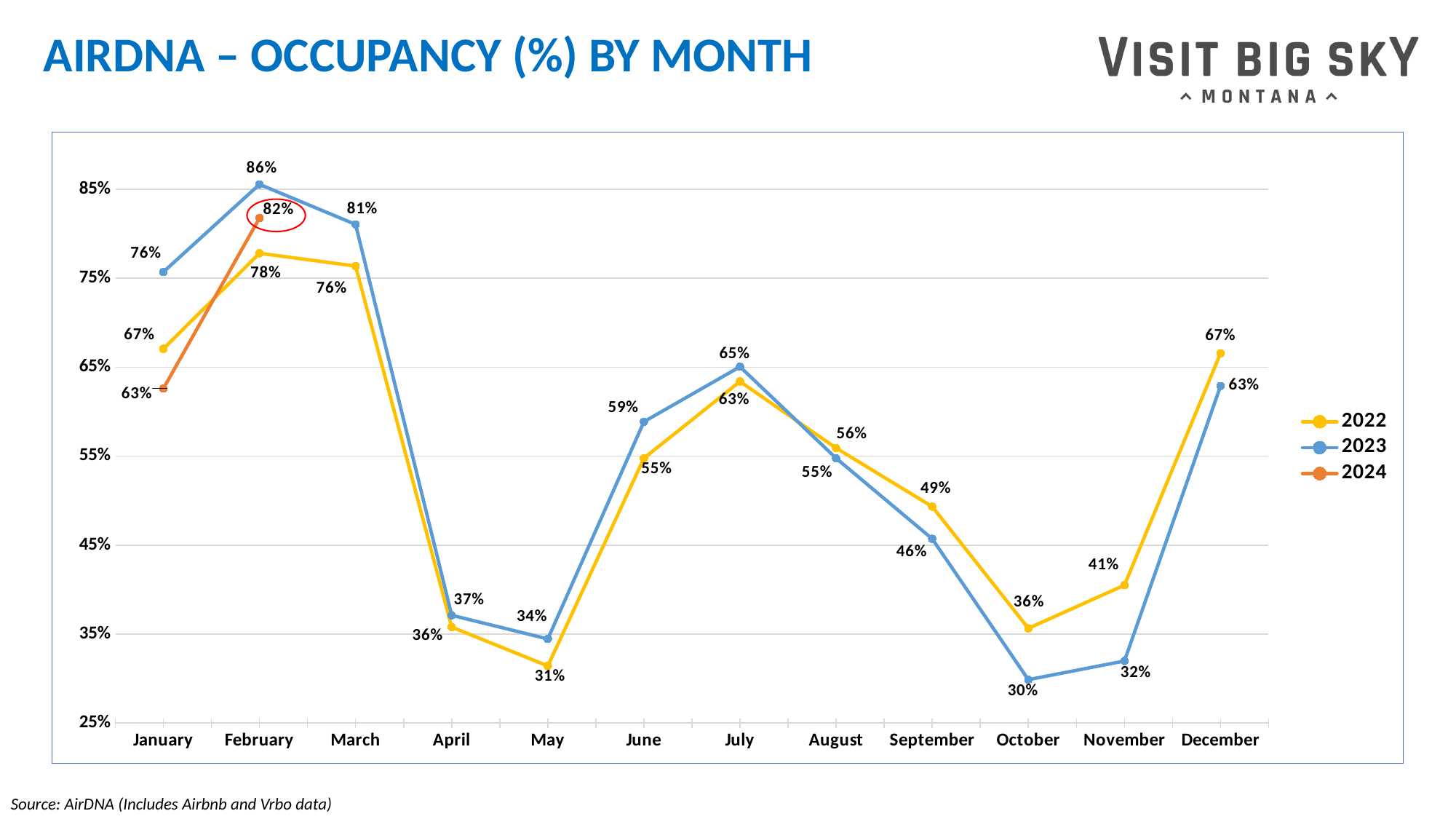
How many months are shown on the x axis? 12 What is the 2024 occupancy for January? 63% What is the difference between the 2023 and 2022 occupancy in January? 9% Does the 2023 occupancy rise or fall from March to April? Fall Which month has the highest 2022 occupancy? February How many series does the legend list? 3 What is the 2023 occupancy for February? 86% Which month has the lowest 2023 occupancy? October Which is higher in September, the 2022 or the 2023 occupancy? 2022 What kind of chart is shown on the slide? Line chart What is the 2022 occupancy for May? 31% Which data point is circled in red on the chart? 82% (February 2024)